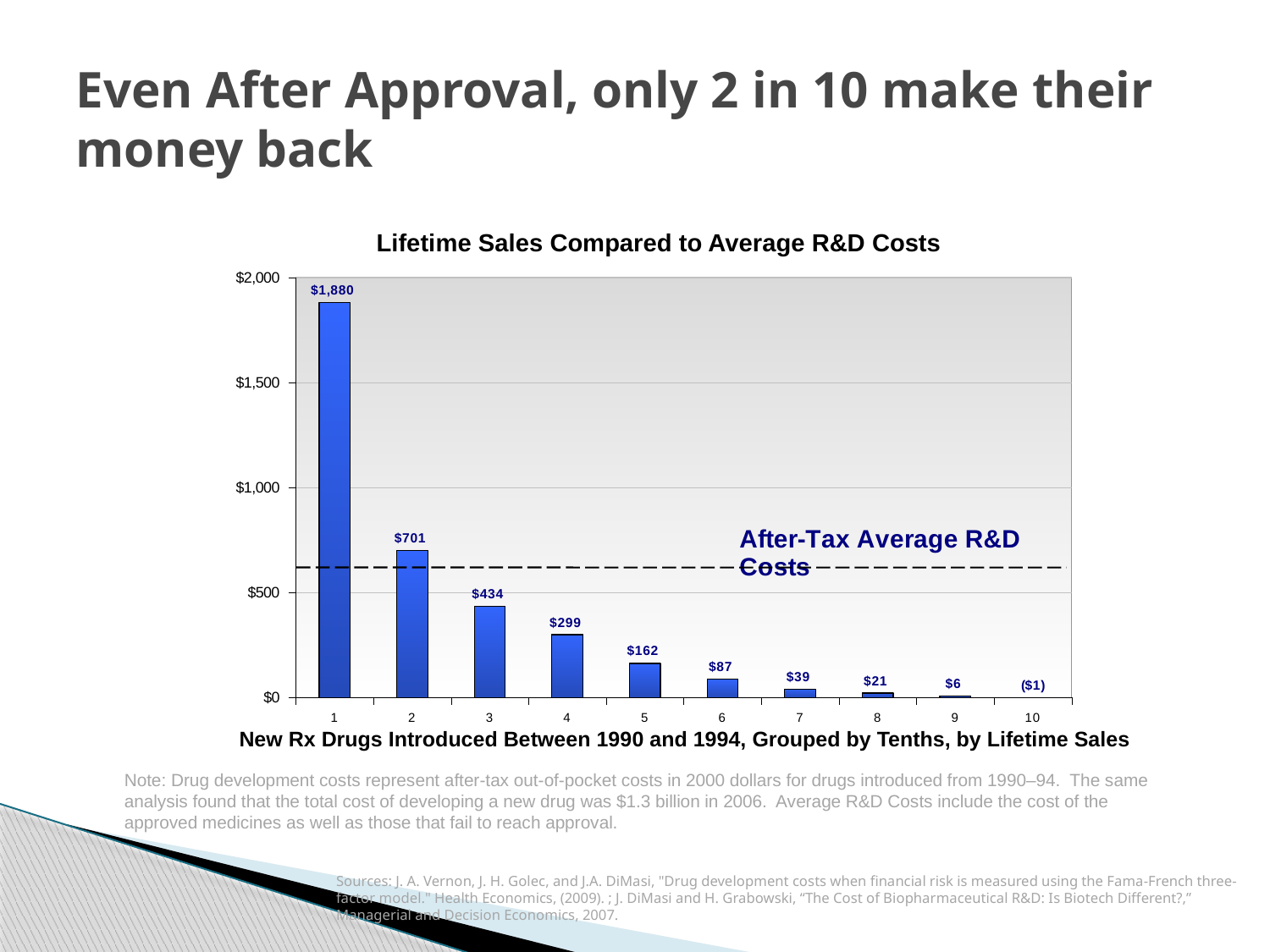
Is the value for group 2 greater or less than $500? greater Which is larger, the value for group 4 or the value for group 5? group 4 What kind of chart is shown on the slide? bar chart Do the values rise or fall from group 1 to group 10? fall Which group has the lowest lifetime sales? 10 How many groups are shown on the x axis? 10 What is the value for group 1 in the chart? $1,880 What is the title of the chart? Lifetime Sales Compared to Average R&D Costs What is the difference between the values for group 1 and group 2? $1,179 Which group has the highest lifetime sales? 1 What is the value for group 3 in the chart? $434 What is the value for group 10 in the chart? ($1)